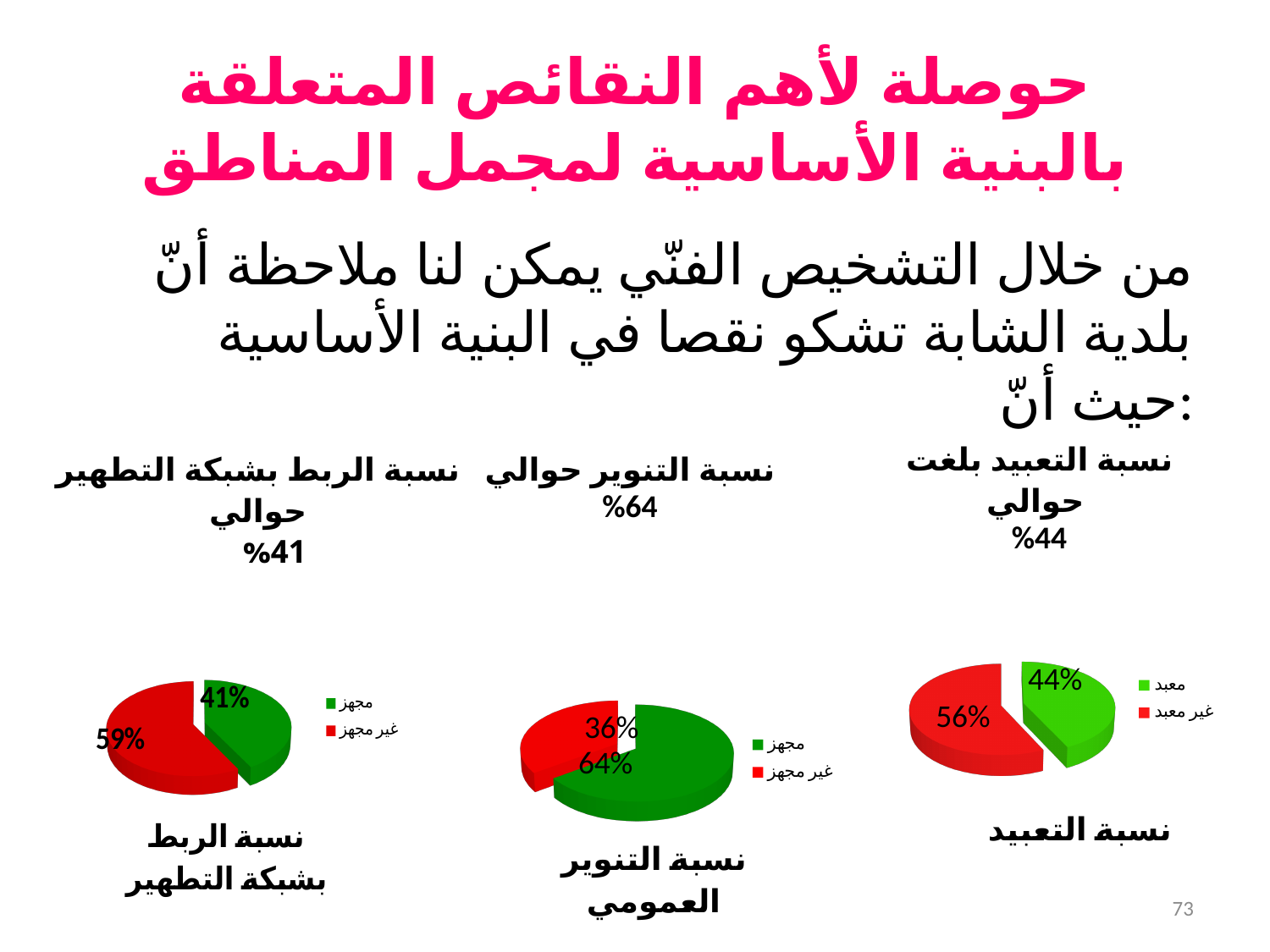
In the pie chart titled نسبة الربط بشبكة التطهير, which slice is the largest? غير مجهز In the pie chart titled نسبة التنوير العمومي, which slice is the smallest? غير مجهز In the pie chart titled نسبة التعبيد, what share is labelled غير معبد? 56% How many slices does the pie chart titled نسبة التعبيد have? 2 How many entries does the legend of the pie chart titled نسبة الربط بشبكة التطهير list? 2 What type of chart is the chart titled نسبة التنوير العمومي? pie chart In the pie chart titled نسبة التعبيد, what is the difference between the غير معبد and معبد shares? 12% In the pie chart titled نسبة الربط بشبكة التطهير, what share is labelled مجهز? 41% In the pie chart titled نسبة الربط بشبكة التطهير, which is larger, مجهز or غير مجهز? غير مجهز In the pie chart titled نسبة التنوير العمومي, what share is labelled غير مجهز? 36% In the pie chart titled نسبة التنوير العمومي, what share is labelled مجهز? 64% In the pie chart titled نسبة التعبيد, what share is labelled معبد? 44%